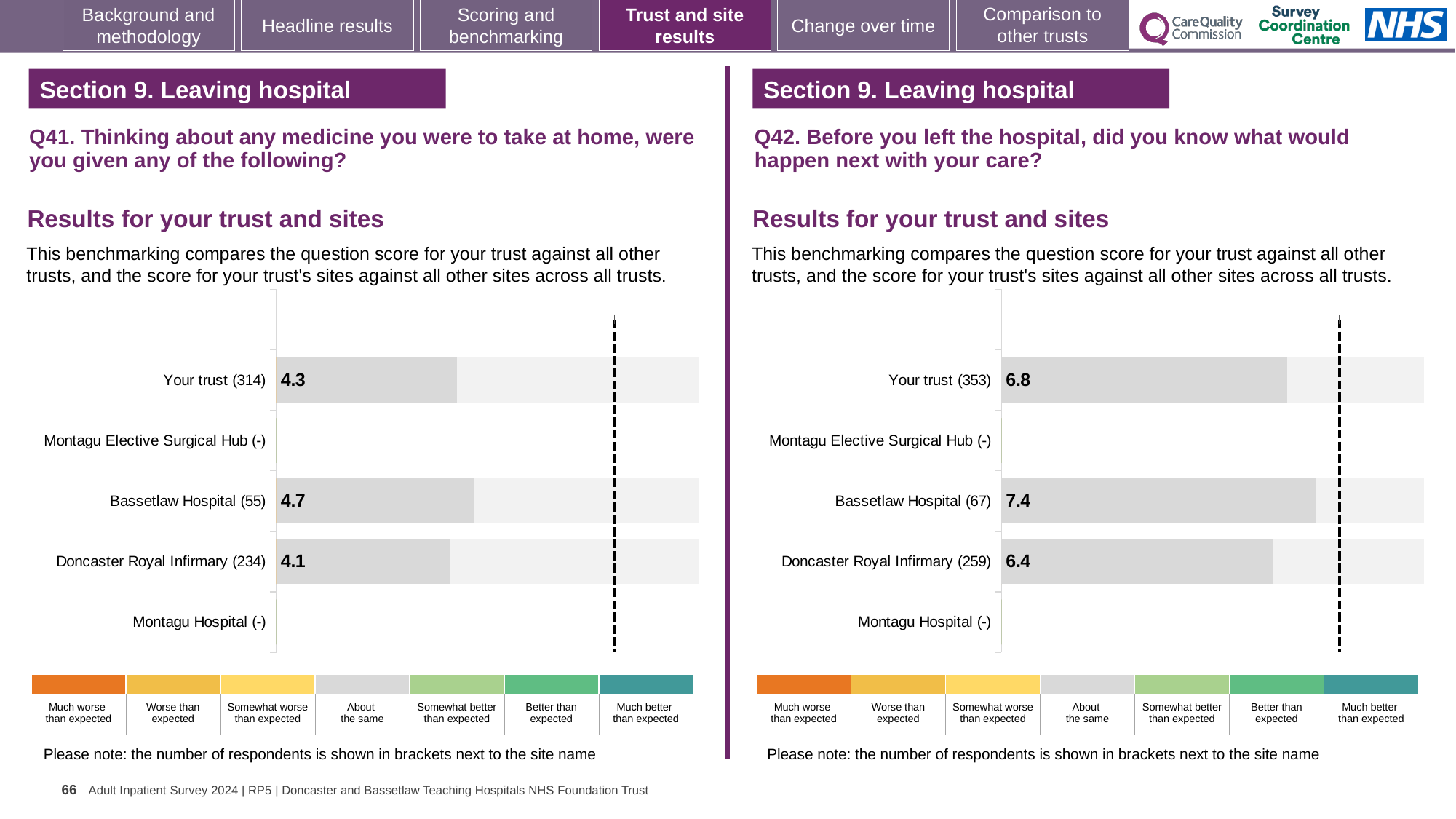
In the Q41 chart on the left, what is the difference between the Bassetlaw Hospital score and the Doncaster Royal Infirmary score? 0.6 What kind of chart is the Q41 chart on the left? Bar chart In the Q42 chart on the right, which site with a plotted score has the lowest value? Doncaster Royal Infirmary In the Q42 chart on the right, what is the score for Doncaster Royal Infirmary? 6.4 In the Q42 chart on the right, is the score for Bassetlaw Hospital or Doncaster Royal Infirmary larger? Bassetlaw Hospital In the Q42 chart on the right, what is the score for Your trust? 6.8 In the Q41 chart on the left, which site with a plotted score has the highest value? Bassetlaw Hospital In the Q41 chart on the left, what is the score for Doncaster Royal Infirmary? 4.1 In the Q41 chart on the left, what is the score for Bassetlaw Hospital? 4.7 In the Q42 chart on the right, how many respondents are shown in brackets for Your trust? 353 In the Q42 chart on the right, what is the score for Bassetlaw Hospital? 7.4 In the Q41 chart on the left, what is the score for Your trust? 4.3